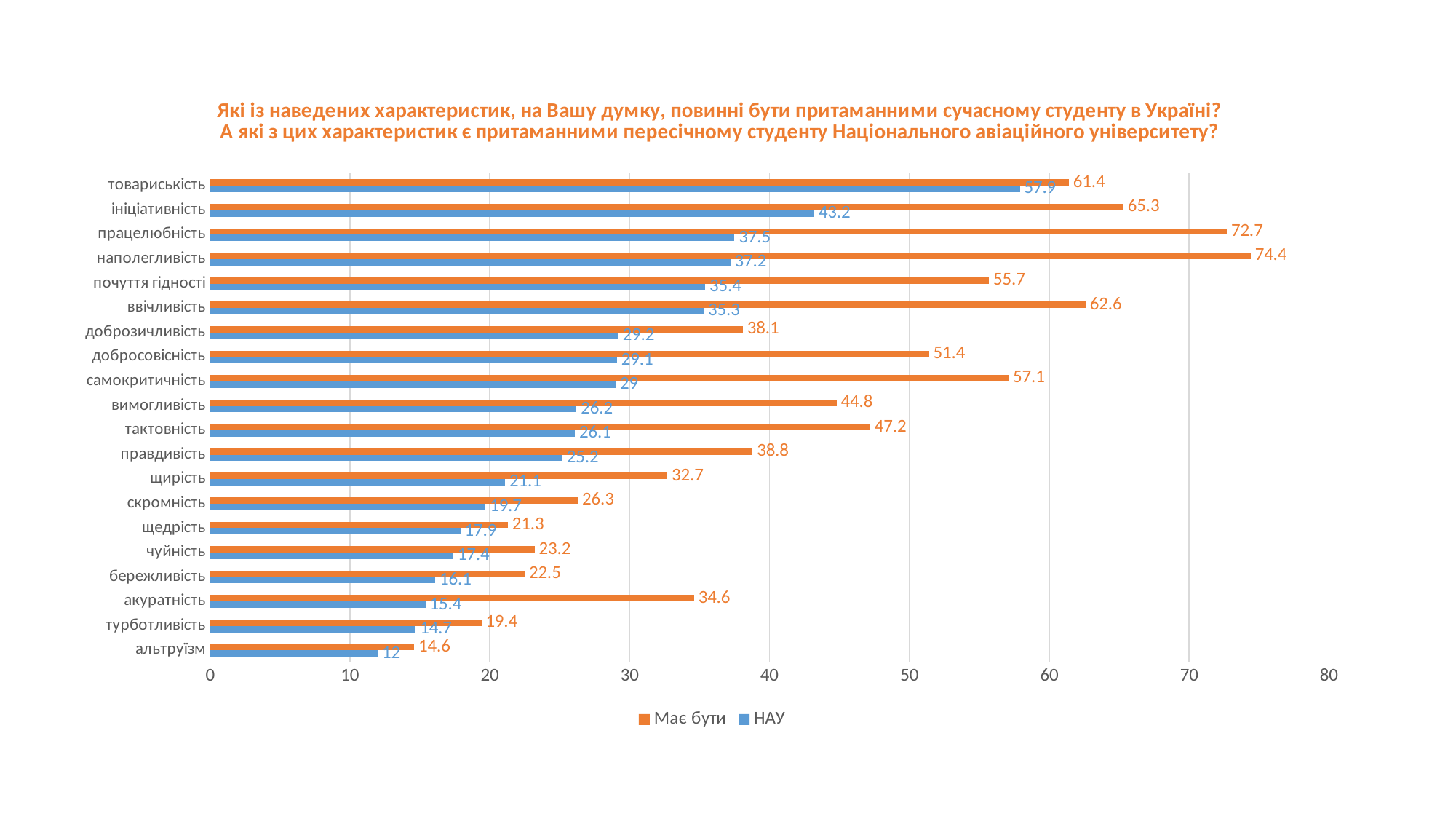
Which is larger: the "Має бути" value for акуратність or the "Має бути" value for скромність? акуратність How many categories (characteristics) are plotted on the chart? 20 What is the value of "НАУ" for ініціативність? 43.2 What is the difference between the "Має бути" and "НАУ" values for наполегливість? 37.2 What is the value of "Має бути" for працелюбність? 72.7 What type of chart is shown on the slide? bar chart Which category has the highest "Має бути" value? наполегливість What is the value of "НАУ" for альтруїзм? 12 Which category has the lowest "НАУ" value? альтруїзм Which category has the highest "НАУ" value? товариськість Which series is shown in orange in the legend? Має бути How many series does the legend list? 2